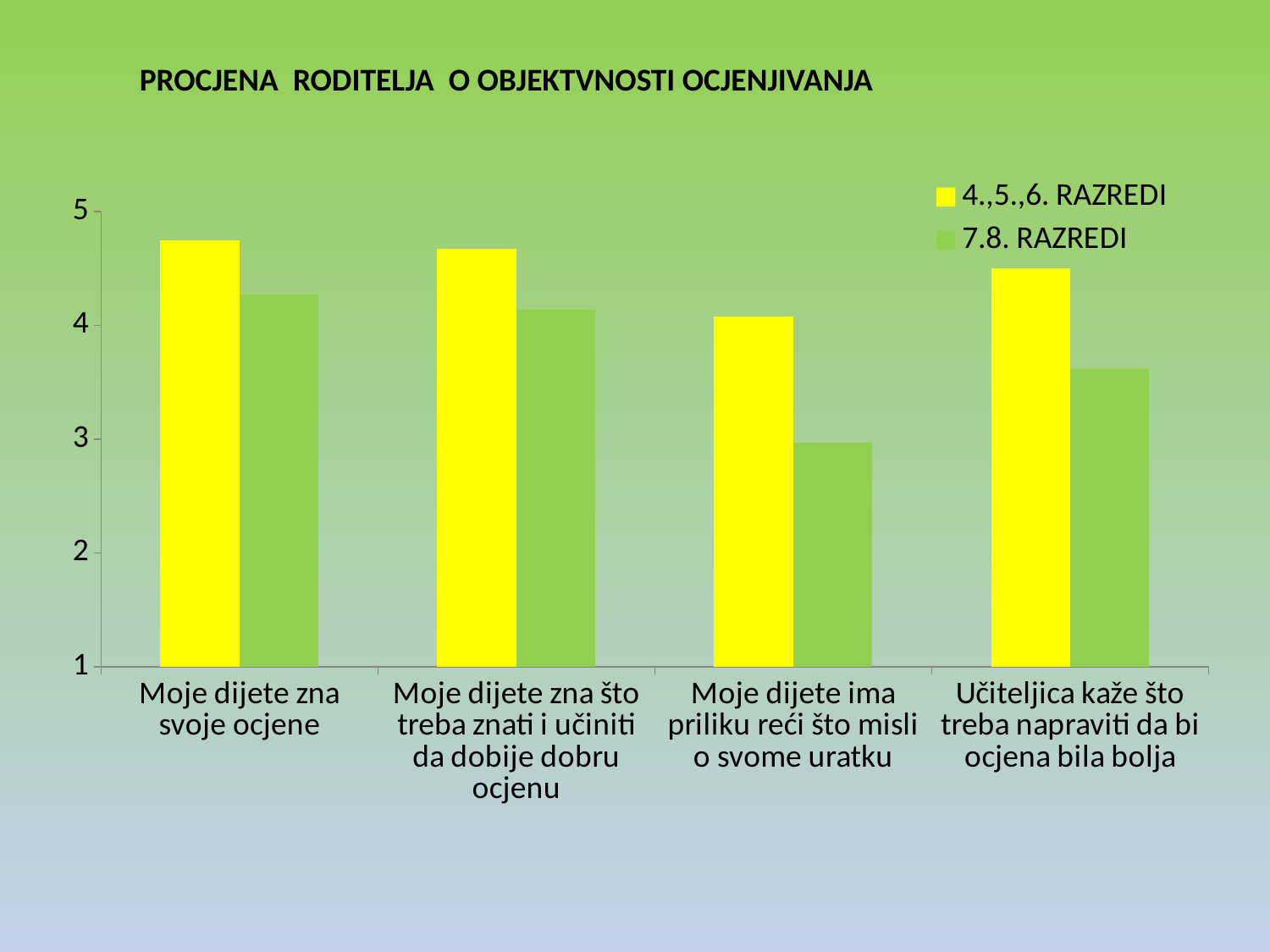
How many categories are shown on the x axis? 4 For which category is the value for 7.8. RAZREDI lowest? Moje dijete ima priliku reći što misli o svome uratku Is the value for 7.8. RAZREDI in the category 'Učiteljica kaže što treba napraviti da bi ocjena bila bolja' greater or less than 4? less In the category 'Učiteljica kaže što treba napraviti da bi ocjena bila bolja', which series has the larger value, 4.,5.,6. RAZREDI or 7.8. RAZREDI? 4.,5.,6. RAZREDI What kind of chart is shown on the slide? bar chart Is the value for 7.8. RAZREDI in the category 'Moje dijete zna svoje ocjene' greater or less than 4? greater How many series does the legend list? 2 In the category 'Moje dijete ima priliku reći što misli o svome uratku', which series has the larger value, 4.,5.,6. RAZREDI or 7.8. RAZREDI? 4.,5.,6. RAZREDI Which series is shown in yellow? 4.,5.,6. RAZREDI Is the value for 4.,5.,6. RAZREDI in the category 'Učiteljica kaže što treba napraviti da bi ocjena bila bolja' greater or less than 4? greater What is the title of the chart? PROCJENA RODITELJA O OBJEKTVNOSTI OCJENJIVANJA For which category is the value for 4.,5.,6. RAZREDI lowest? Moje dijete ima priliku reći što misli o svome uratku